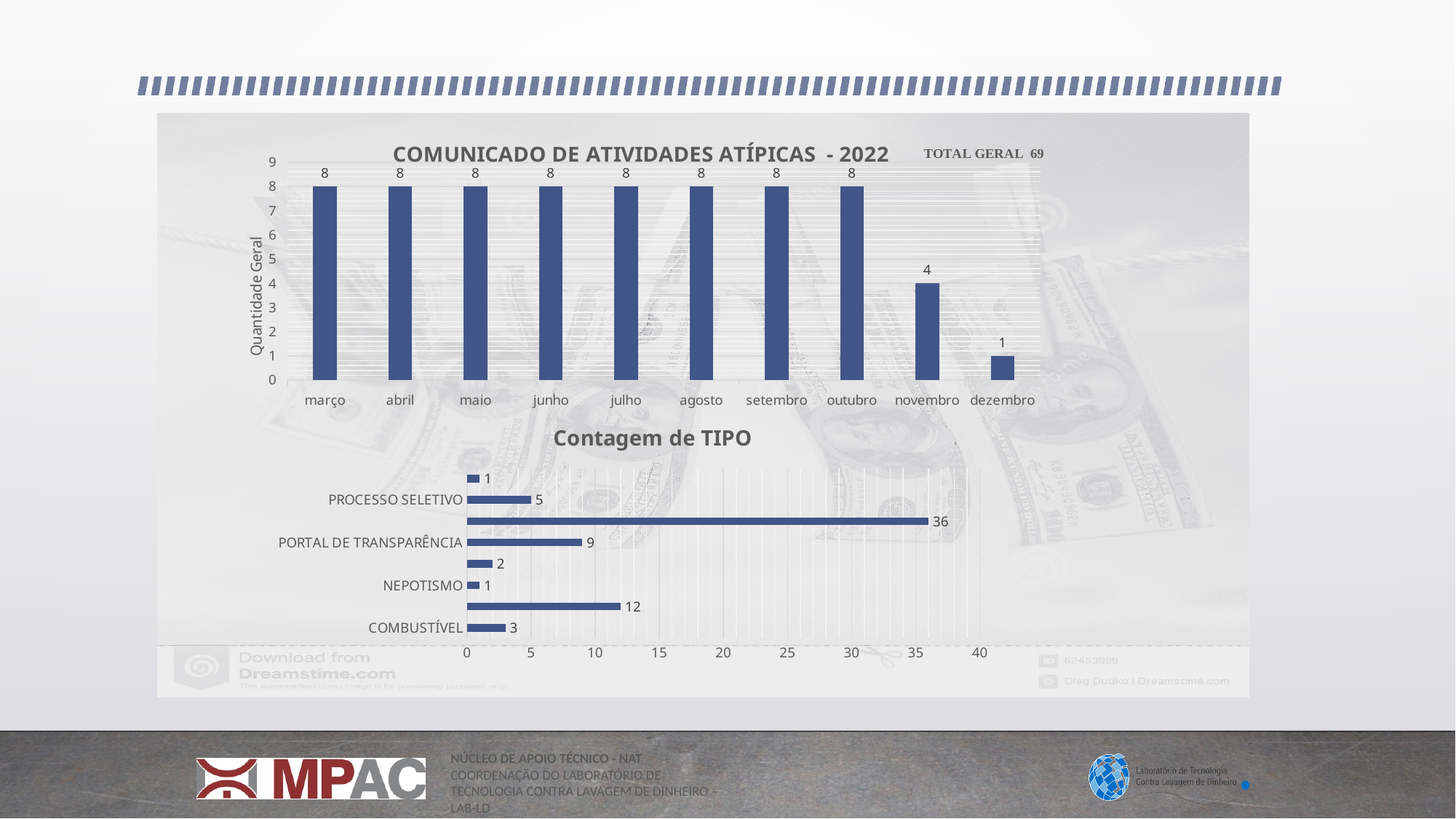
In the chart titled 'COMUNICADO DE ATIVIDADES ATÍPICAS - 2022', what is the value for março? 8 What kind of chart is the chart titled 'Contagem de TIPO'? bar chart In the chart titled 'COMUNICADO DE ATIVIDADES ATÍPICAS - 2022', what is the value for dezembro? 1 In the chart titled 'COMUNICADO DE ATIVIDADES ATÍPICAS - 2022', what is the label of the vertical axis? Quantidade Geral In the chart titled 'COMUNICADO DE ATIVIDADES ATÍPICAS - 2022', what is the difference between the values for outubro and novembro? 4 In the chart titled 'COMUNICADO DE ATIVIDADES ATÍPICAS - 2022', which month has the lowest value? dezembro In the chart titled 'COMUNICADO DE ATIVIDADES ATÍPICAS - 2022', what is the value for novembro? 4 In the chart titled 'Contagem de TIPO', which is larger, the value for COMBUSTÍVEL or the value for NEPOTISMO? COMBUSTÍVEL In the chart titled 'Contagem de TIPO', what is the value for PORTAL DE TRANSPARÊNCIA? 9 In the chart titled 'COMUNICADO DE ATIVIDADES ATÍPICAS - 2022', what total is printed next to the title? TOTAL GERAL 69 In the chart titled 'COMUNICADO DE ATIVIDADES ATÍPICAS - 2022', how many months are shown on the x axis? 10 In the chart titled 'Contagem de TIPO', what is the value for PROCESSO SELETIVO? 5